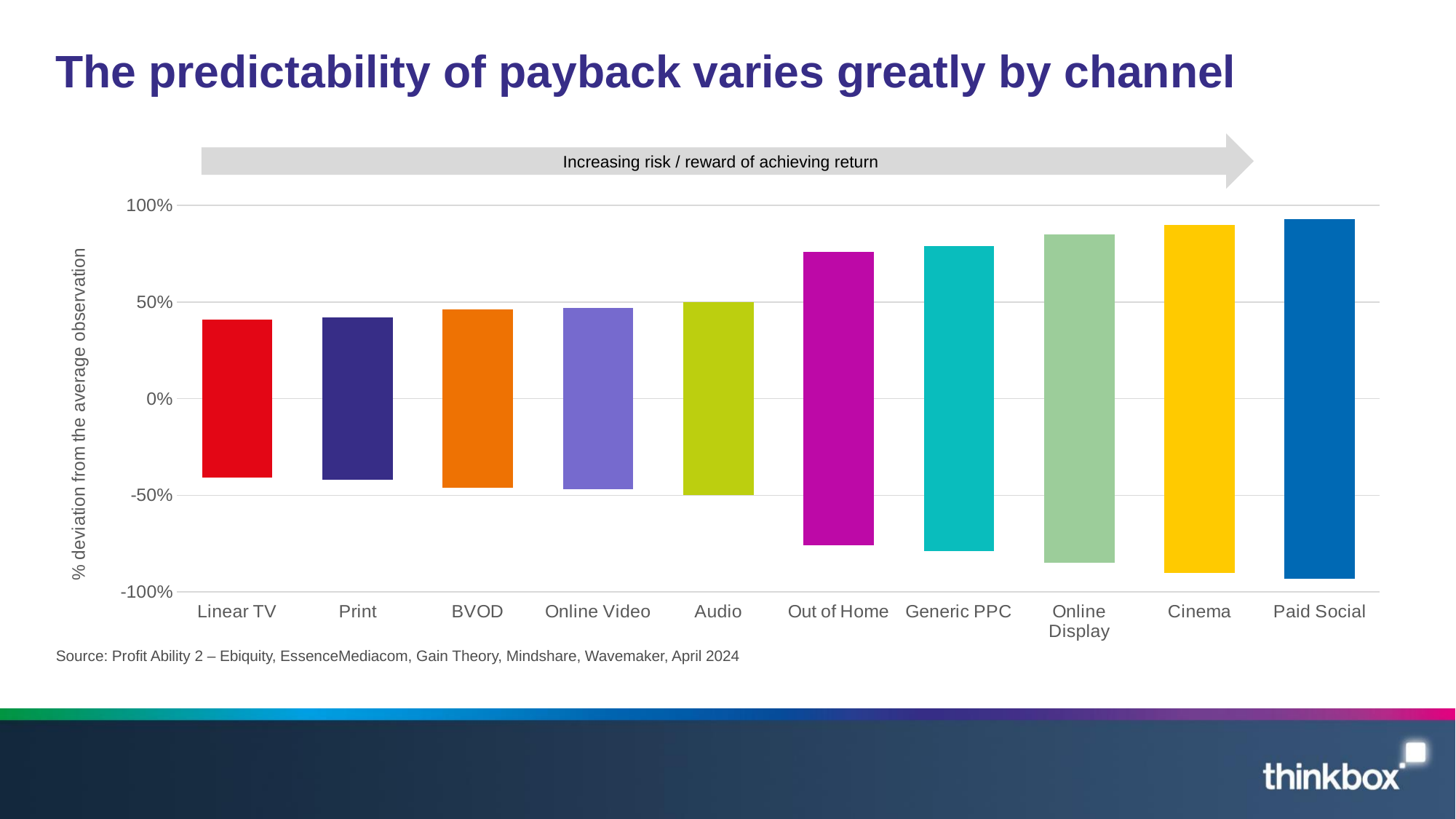
Is the upper end of the bar for Paid Social greater or less than 50%? greater Which channel has a wider range of deviation, Cinema or Print? Cinema Which channel has the widest range of % deviation from the average observation? Paid Social Is the upper end of the bar for Out of Home greater or less than 50%? greater What does the arrow above the chart say? Increasing risk / reward of achieving return How many channels are shown on the x axis of the chart? 10 Is the upper end of the bar for Print greater or less than 50%? less What kind of chart is shown on the slide? bar chart Do the ranges of deviation widen or narrow moving from left to right along the x axis? widen Which channel has the narrowest range of % deviation from the average observation? Linear TV What is the title of the chart on the slide? The predictability of payback varies greatly by channel